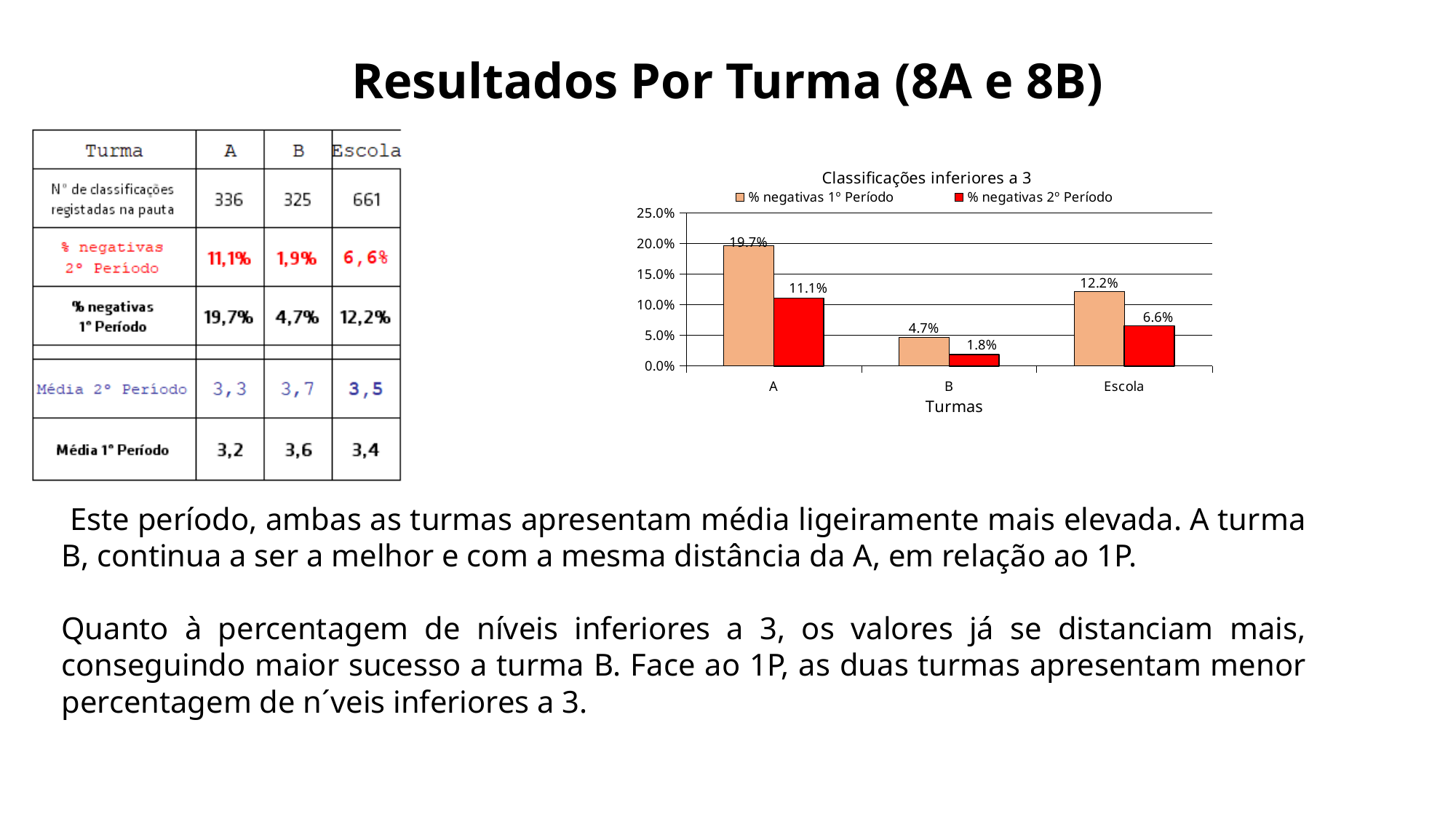
Which category has the lowest value for % negativas 2º Período? B What kind of chart is shown on the slide? bar chart Which is larger for Escola: % negativas 1º Período or % negativas 2º Período? % negativas 1º Período Is the value of % negativas 1º Período for Escola greater or less than 10.0%? greater How many categories are shown on the x axis of the chart? 3 What is the value of % negativas 1º Período for turma A? 19.7% What is the title of the chart? Classificações inferiores a 3 What is the value of % negativas 2º Período for Escola? 6.6% Which category has the highest value for % negativas 1º Período? A How many series does the chart legend list? 2 What is the difference between % negativas 1º Período and % negativas 2º Período for turma A? 8.6% What is the value of % negativas 2º Período for turma B? 1.8%